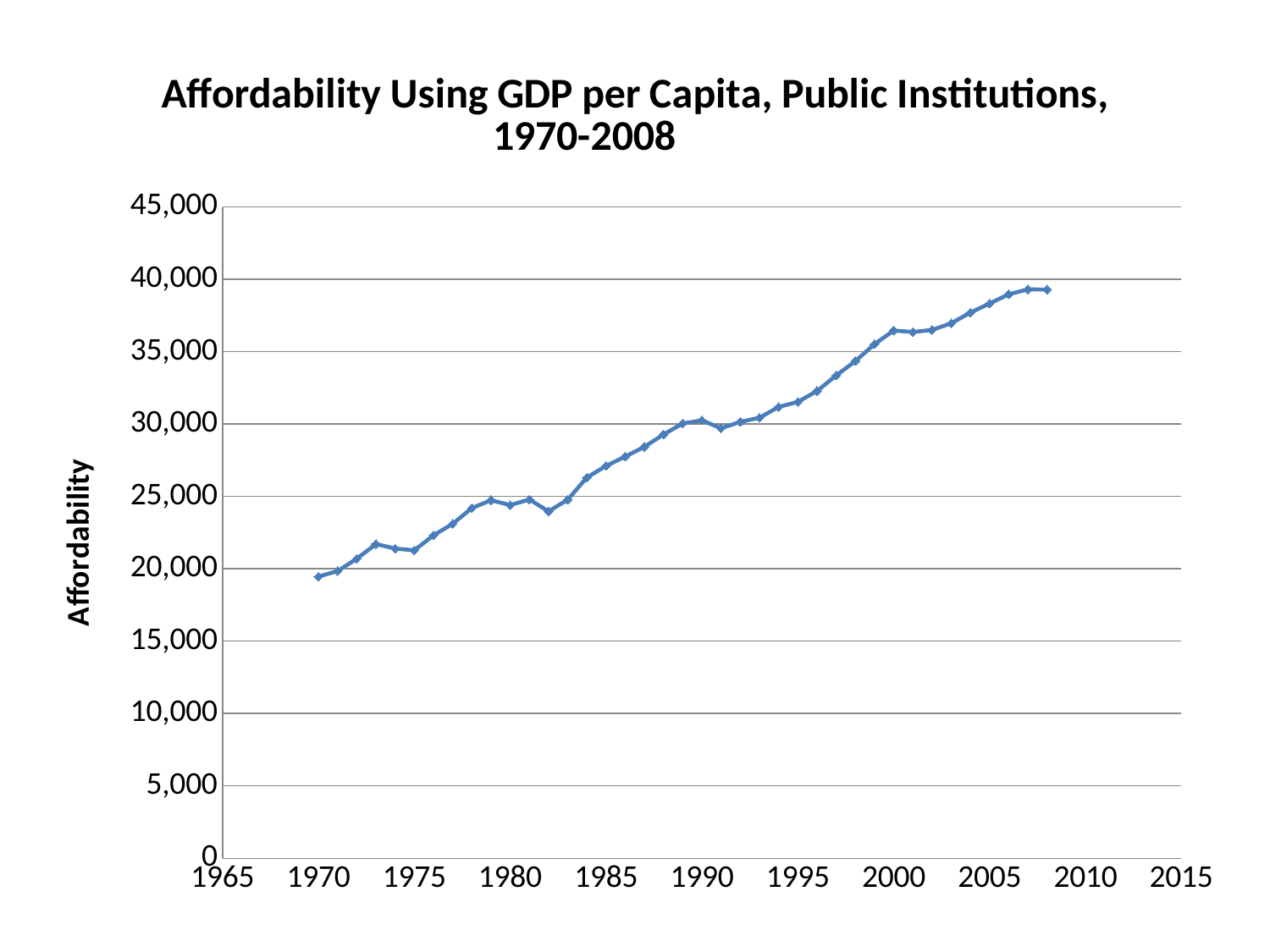
Which year has the larger affordability value, 1990 or 2000? 2000 What kind of chart is shown on the slide? line chart What is the label on the vertical axis? Affordability Is the affordability value for 1980 greater or less than 25,000? less Is the affordability value for 2000 greater or less than 35,000? greater Do the affordability values generally rise or fall from 1970 to 2008? rise Which year has the larger affordability value, 1975 or 1995? 1995 What is the title of the chart? Affordability Using GDP per Capita, Public Institutions, 1970-2008 Which year has the lowest affordability value? 1970 Is the affordability value for 1970 greater or less than 20,000? less